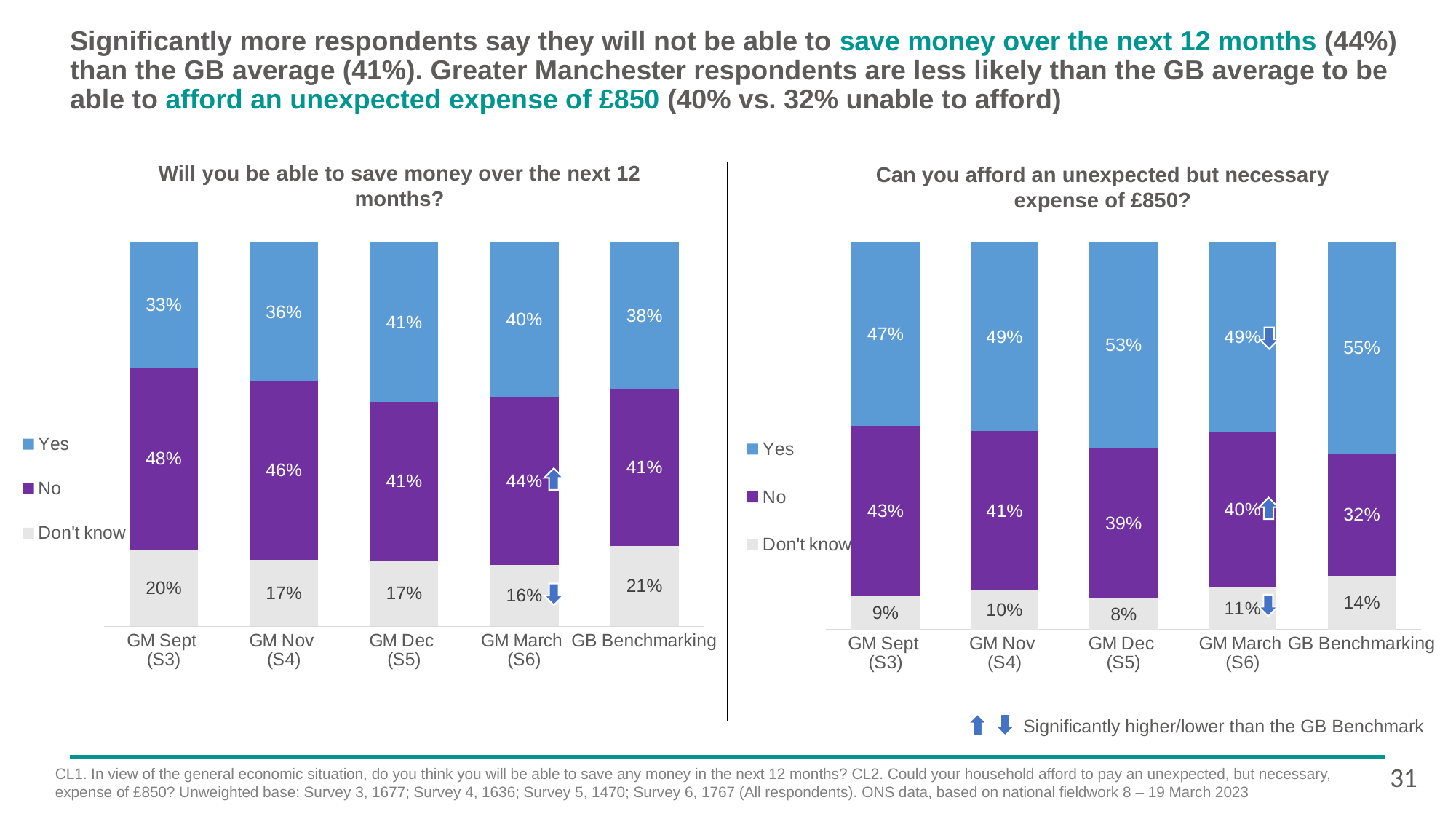
In the chart 'Can you afford an unexpected but necessary expense of £850?', how does the No value change from GM Sept (S3) to GM Dec (S5)? It falls In the chart 'Can you afford an unexpected but necessary expense of £850?', what percentage of GM Dec (S5) respondents answered Yes? 53% In the chart 'Will you be able to save money over the next 12 months?', which category has the highest Yes value? GM Dec (S5) In the chart 'Will you be able to save money over the next 12 months?', what is the Don't know value for GB Benchmarking? 21% How many series does the legend list for the chart 'Can you afford an unexpected but necessary expense of £850?'? 3 In the chart 'Will you be able to save money over the next 12 months?', what percentage of GM Sept (S3) respondents answered No? 48% In the chart 'Will you be able to save money over the next 12 months?', what is the difference between the No value for GM March (S6) and the No value for GB Benchmarking? 3 percentage points What type of chart is 'Will you be able to save money over the next 12 months?'? Stacked bar chart In the chart 'Can you afford an unexpected but necessary expense of £850?', which category has the lowest Don't know value? GM Dec (S5) In the chart 'Can you afford an unexpected but necessary expense of £850?', which is larger: the No value for GM March (S6) or the No value for GB Benchmarking? GM March (S6) In the chart 'Can you afford an unexpected but necessary expense of £850?', what is the difference between the Yes value for GB Benchmarking and the Yes value for GM Sept (S3)? 8 percentage points In the chart 'Will you be able to save money over the next 12 months?', how many categories are shown on the x axis? 5